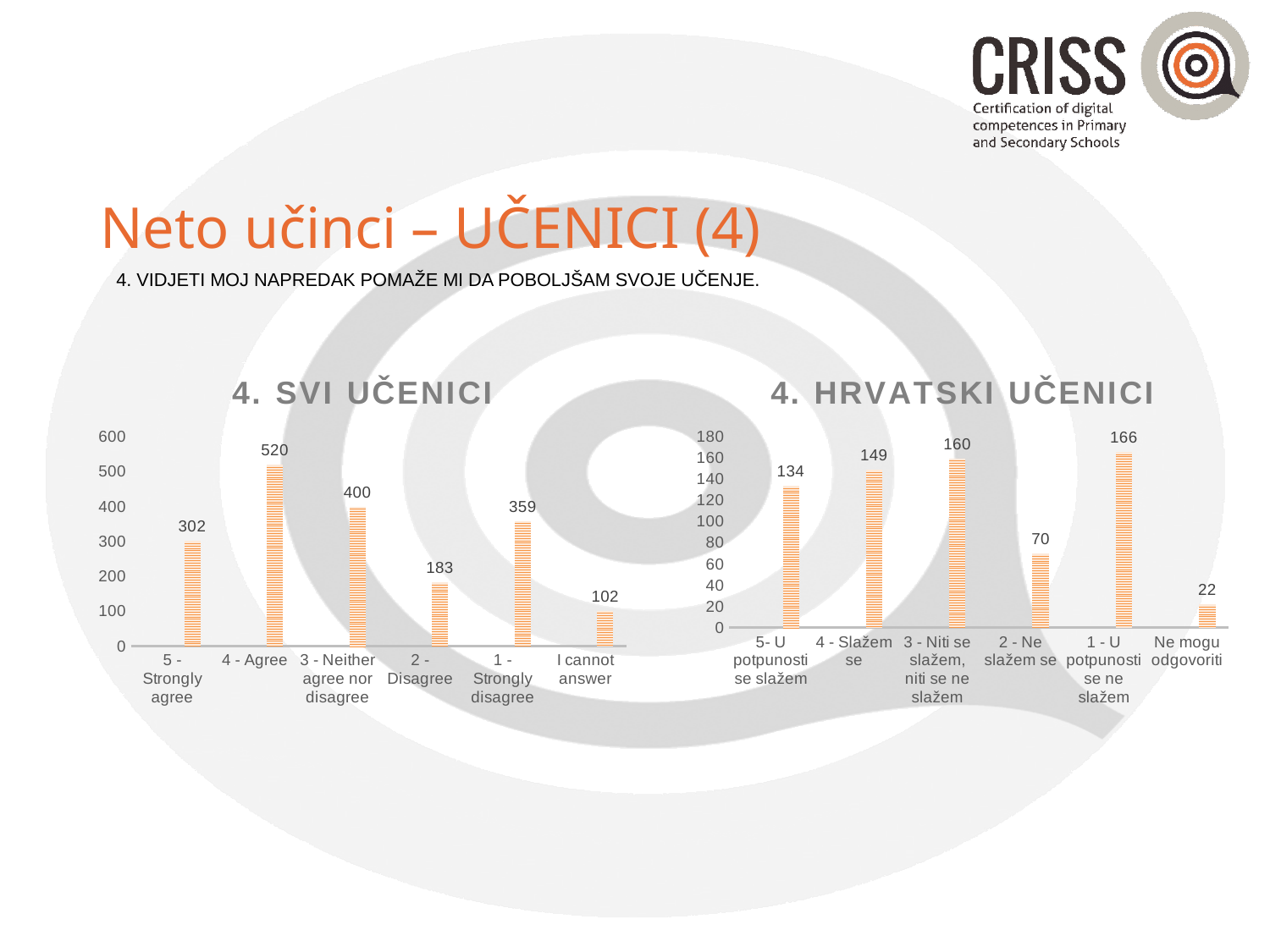
In the '4. SVI UČENICI' chart, which category has the lowest value? I cannot answer In the '4. HRVATSKI UČENICI' chart, what is the value for 'Ne mogu odgovoriti'? 22 What kind of chart is the '4. HRVATSKI UČENICI' chart? Bar chart In the '4. HRVATSKI UČENICI' chart, what is the value for '2 - Ne slažem se'? 70 In the '4. SVI UČENICI' chart, what is the difference between '4 - Agree' and '3 - Neither agree nor disagree'? 120 What is the title of the chart on the left side of the slide? 4. SVI UČENICI In the '4. SVI UČENICI' chart, how many categories are shown on the x axis? 6 In the '4. HRVATSKI UČENICI' chart, what is the difference between '3 - Niti se slažem, niti se ne slažem' and '5- U potpunosti se slažem'? 26 In the '4. SVI UČENICI' chart, what is the value for '4 - Agree'? 520 In the '4. SVI UČENICI' chart, what is the value for '2 - Disagree'? 183 In the '4. SVI UČENICI' chart, which is larger: '5 - Strongly agree' or '1 - Strongly disagree'? 1 - Strongly disagree In the '4. HRVATSKI UČENICI' chart, which category has the highest value? 1 - U potpunosti se ne slažem